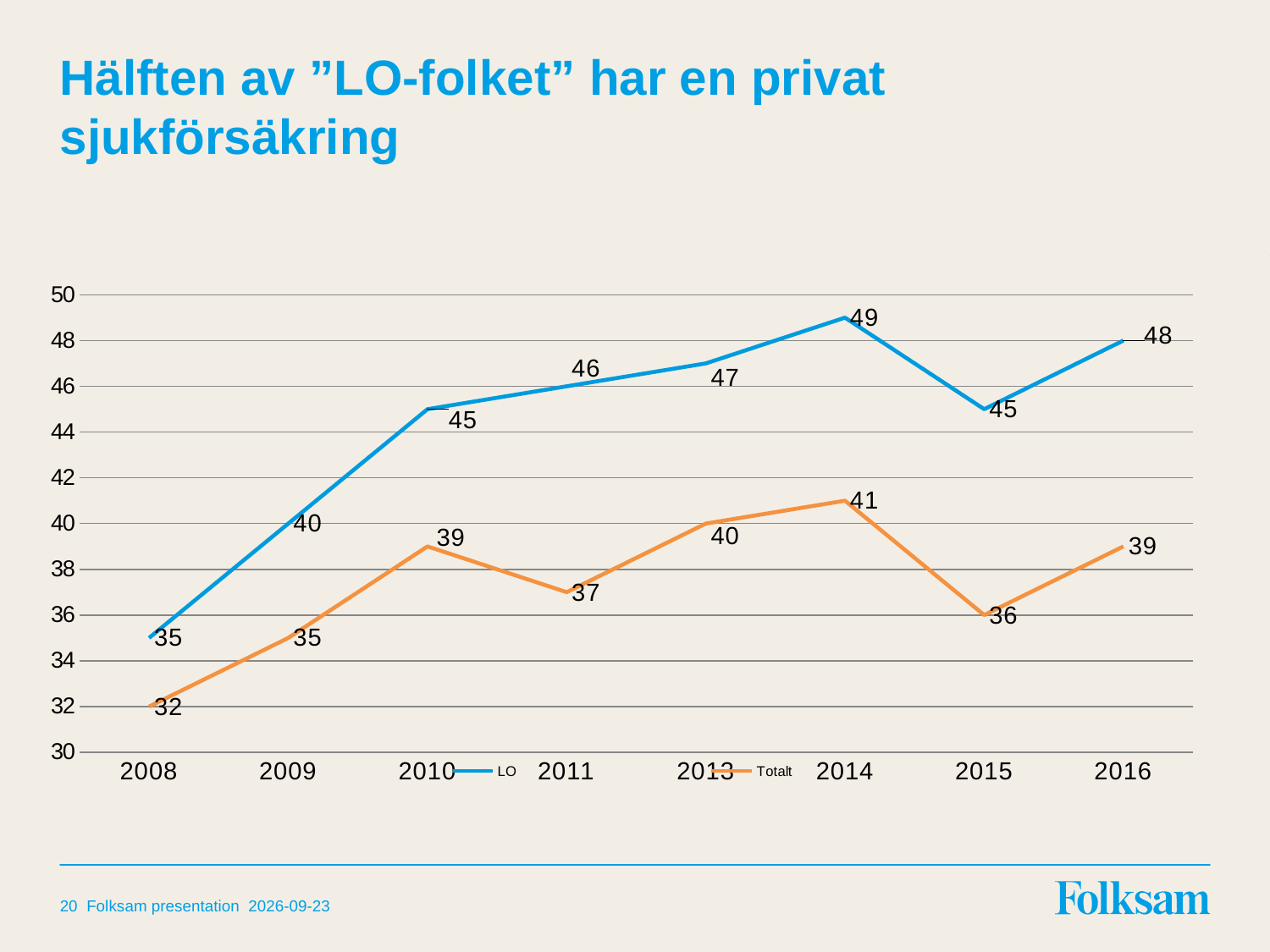
What is the value for Totalt in 2015? 36 What is the value for LO in 2014? 49 In which year does the LO series reach its highest value? 2014 In which year does the Totalt series have its lowest value? 2008 Which is larger in 2011, the LO value or the Totalt value? LO What kind of chart is shown on the slide? line chart How many series does the legend list? 2 Which series is drawn in orange? Totalt What is the value for Totalt in 2008? 32 What is the difference between the LO and Totalt values in 2010? 6 What is the value for LO in 2016? 48 How many data points does each line have? 8